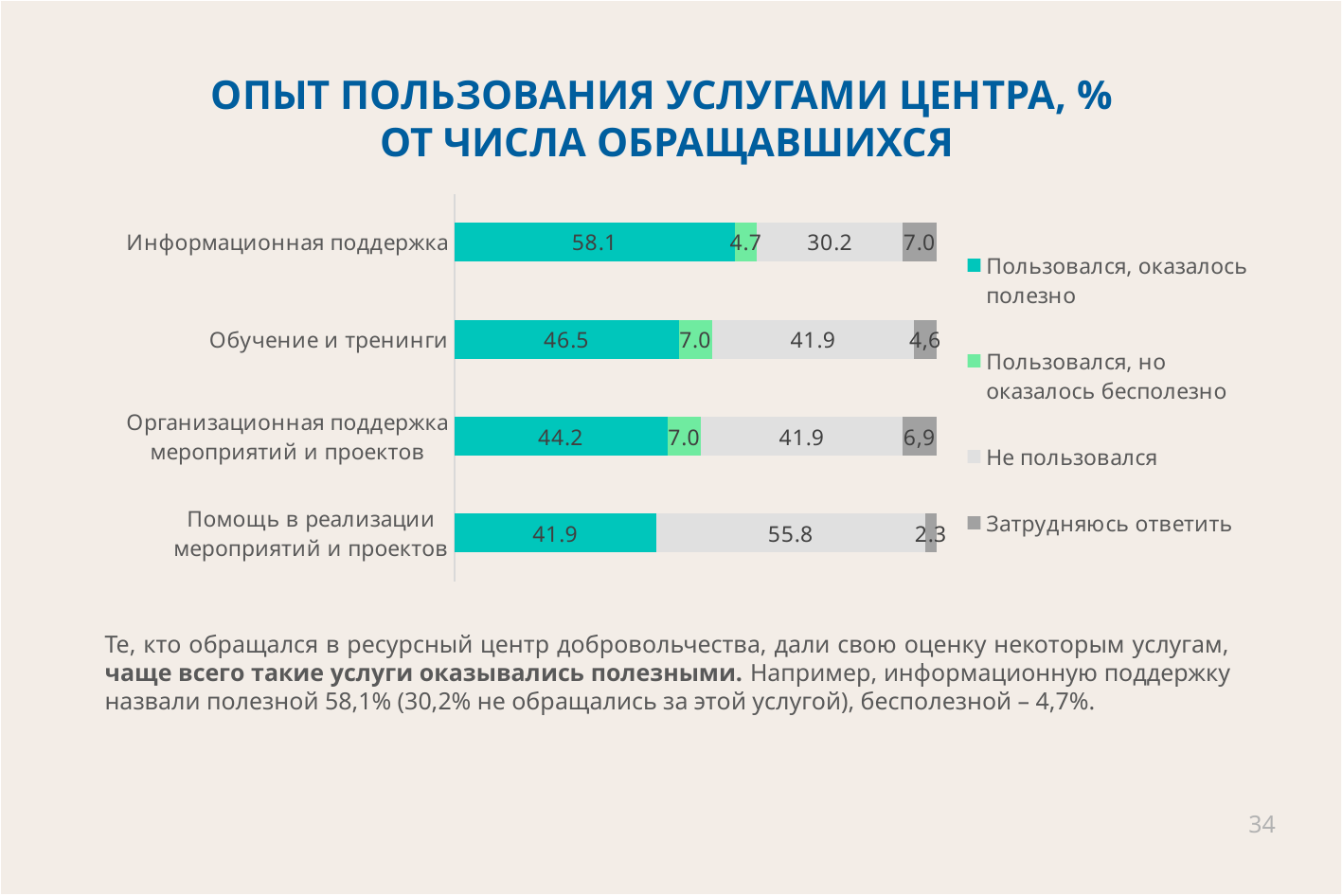
How many categories (services) are shown in the chart? 4 What is the value of "Пользовался, оказалось полезно" for "Информационная поддержка"? 58.1 What is the value of "Пользовался, но оказалось бесполезно" for "Обучение и тренинги"? 7.0 Which service has the lowest value for "Пользовался, оказалось полезно"? Помощь в реализации мероприятий и проектов What is the total of the stacked bar for "Информационная поддержка"? 100.0 What is the value of "Затрудняюсь ответить" for "Организационная поддержка мероприятий и проектов"? 6,9 Which is larger: the "Не пользовался" value for "Обучение и тренинги" or for "Информационная поддержка"? Обучение и тренинги Which service has the highest value for "Пользовался, оказалось полезно"? Информационная поддержка How many series does the legend list? 4 What type of chart is shown on the slide? Stacked bar chart What is the value of "Не пользовался" for "Помощь в реализации мероприятий и проектов"? 55.8 What is the difference between the "Пользовался, оказалось полезно" values for "Информационная поддержка" and "Помощь в реализации мероприятий и проектов"? 16.2